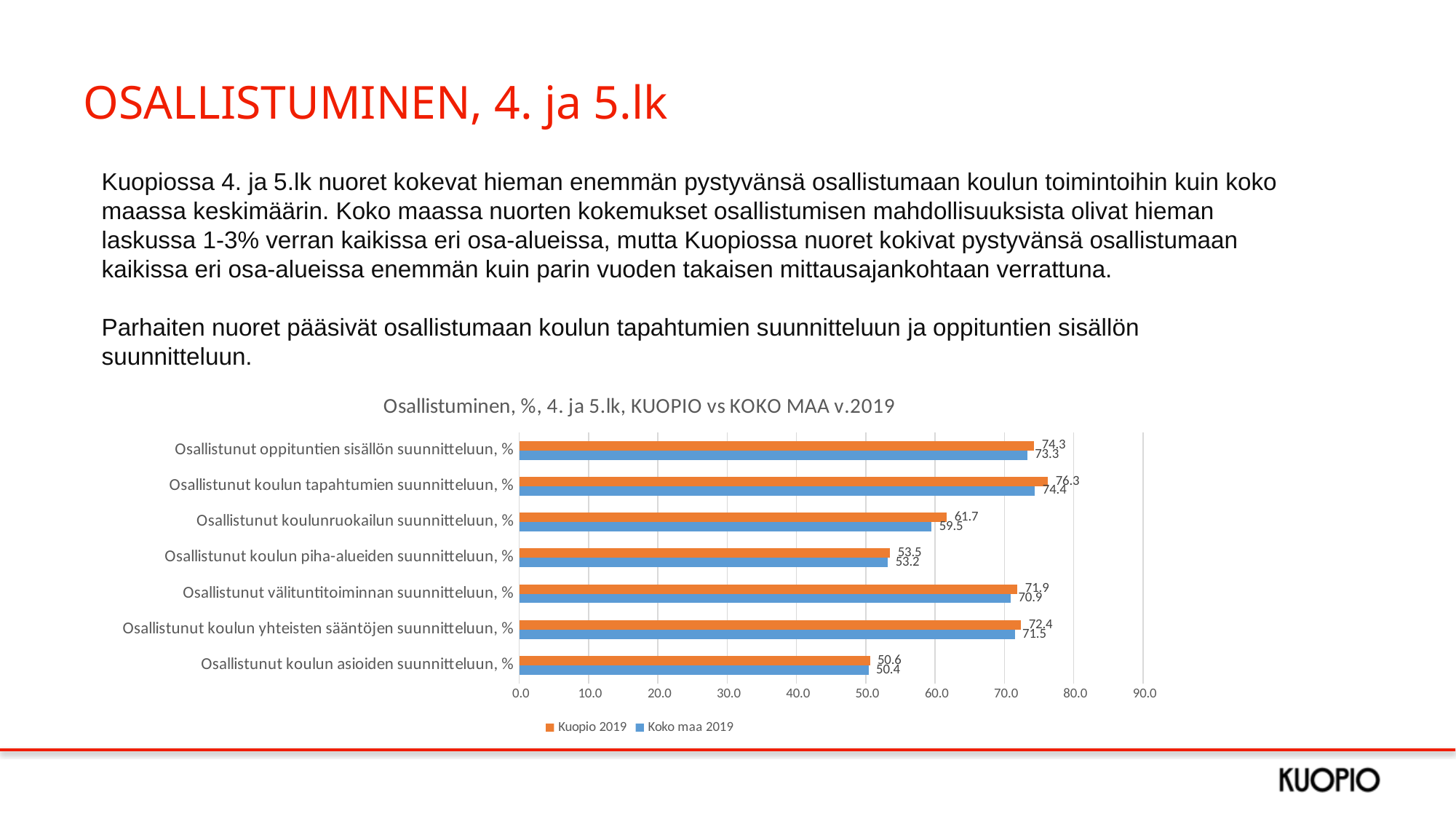
What type of chart is shown on the slide? Bar chart Which category has the lowest Koko maa 2019 value? Osallistunut koulun asioiden suunnitteluun, % What is the Koko maa 2019 value for 'Osallistunut koulun asioiden suunnitteluun, %'? 50.4 For 'Osallistunut välituntitoiminnan suunnitteluun, %', which series has the larger value, Kuopio 2019 or Koko maa 2019? Kuopio 2019 Is the Kuopio 2019 value for 'Osallistunut koulun piha-alueiden suunnitteluun, %' greater or less than 60.0? less What is the title of the chart? Osallistuminen, %, 4. ja 5.lk, KUOPIO vs KOKO MAA v.2019 What is the difference between the Kuopio 2019 and Koko maa 2019 values for 'Osallistunut koulunruokailun suunnitteluun, %'? 2.2 What is the Koko maa 2019 value for 'Osallistunut koulunruokailun suunnitteluun, %'? 59.5 Which category has the highest Kuopio 2019 value? Osallistunut koulun tapahtumien suunnitteluun, % How many categories are shown in the chart? 7 How many series does the legend list? 2 What is the Kuopio 2019 value for 'Osallistunut koulun tapahtumien suunnitteluun, %'? 76.3